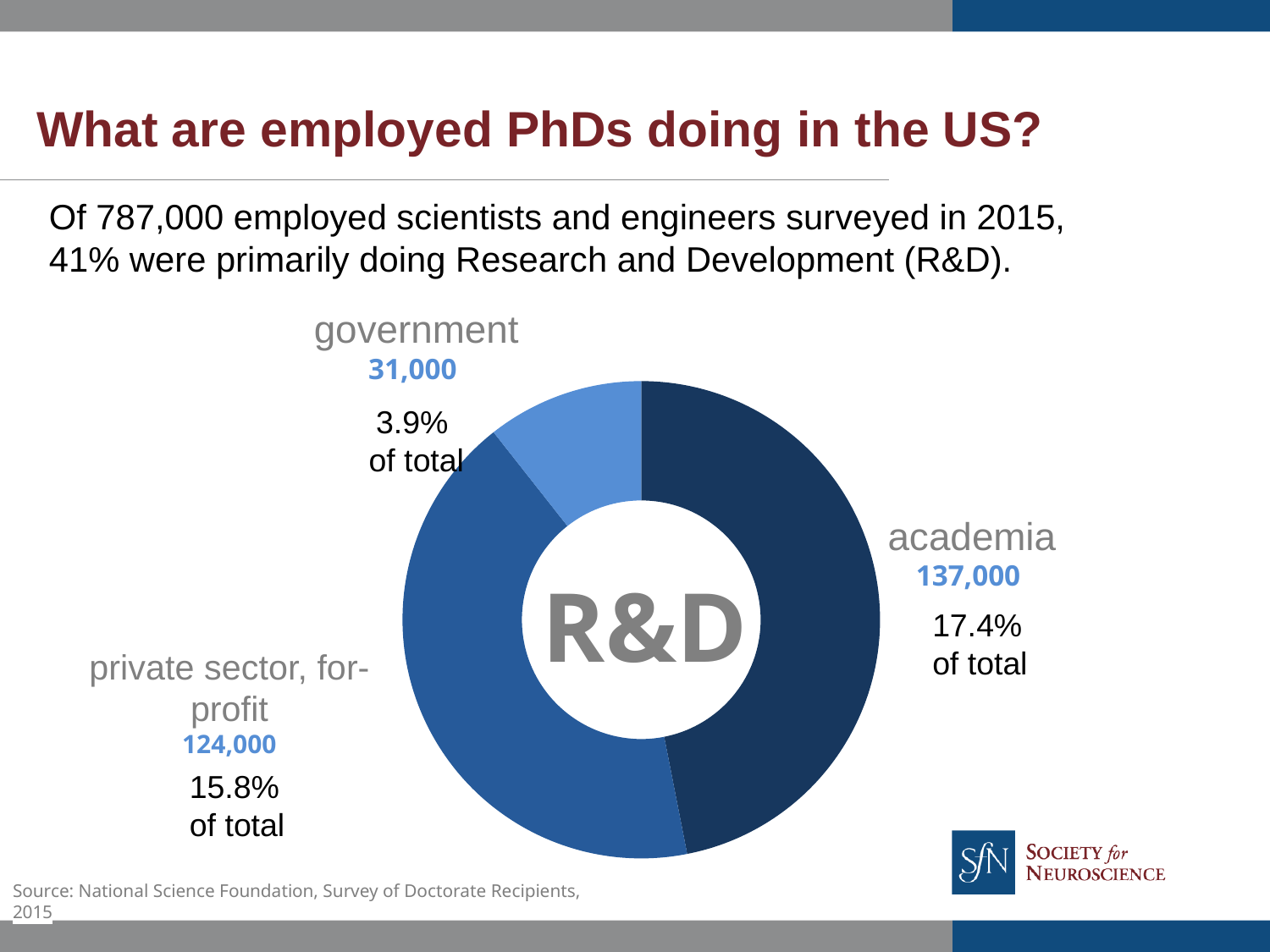
What label appears in the centre of the chart? R&D What is the difference between the academia and private sector, for-profit values? 13,000 How many sectors are shown in the chart? 3 How many employed PhDs are shown doing R&D in academia? 137,000 Which sector has the largest segment in the chart? academia What is the difference between the private sector, for-profit and government values? 93,000 What value is shown for the government segment? 31,000 Which is larger, the value for academia or the value for government? academia What value is shown for the private sector, for-profit segment? 124,000 Which sector has the smallest segment in the chart? government What percentage of the total is shown for academia? 17.4% What percentage of the total is shown for government? 3.9%